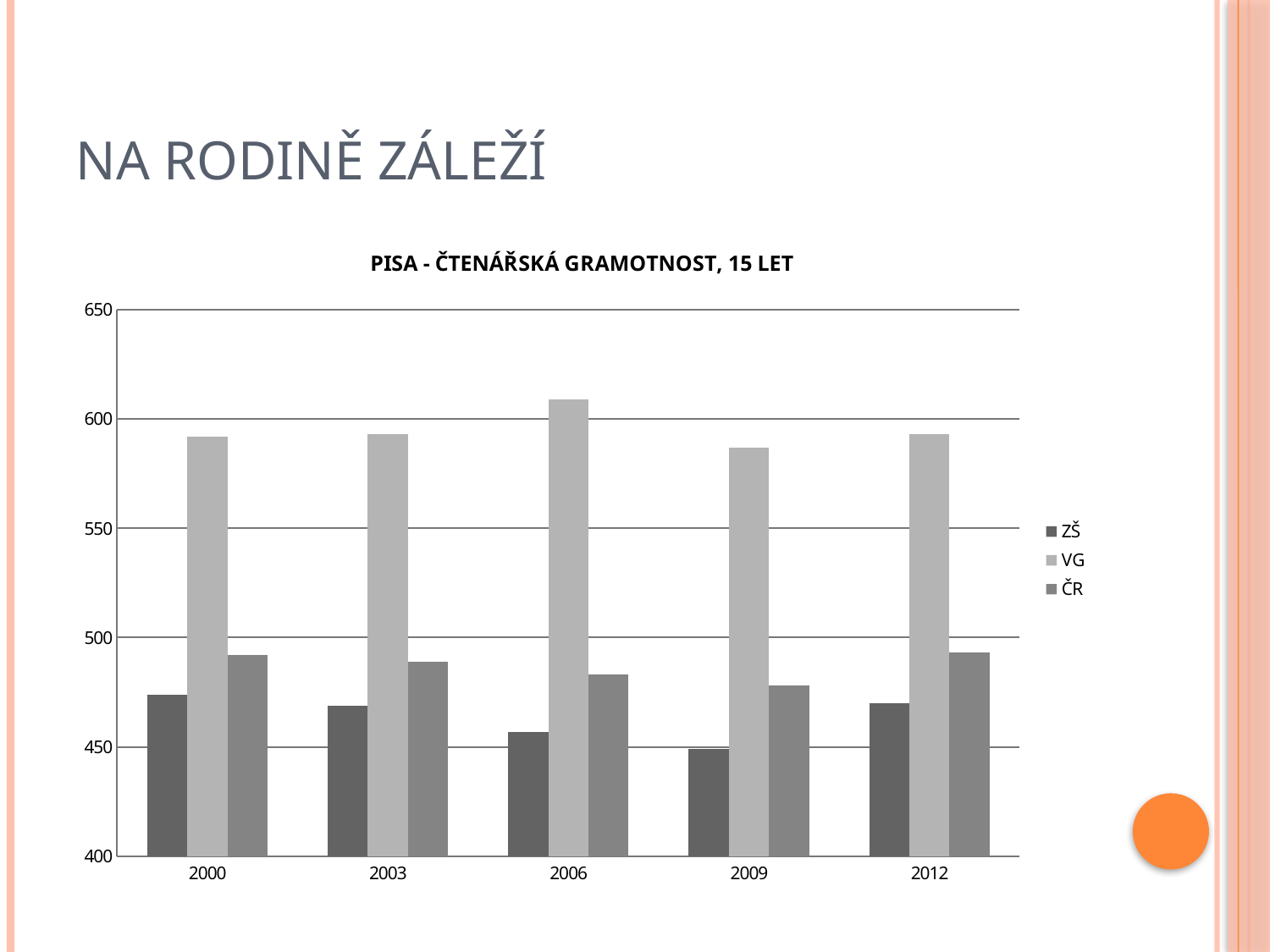
Is the VG value for 2009 greater or less than 600? less Is the VG value for 2006 greater or less than 600? greater In which year is the ZŠ value lowest? 2009 Is the ČR value for 2000 greater or less than 500? less How many years are shown on the x axis? 5 What is the title of the chart? PISA - ČTENÁŘSKÁ GRAMOTNOST, 15 LET In which year is the VG value highest? 2006 Which series are listed in the legend? ZŠ, VG, ČR What kind of chart is shown on the slide? bar chart Which is larger in 2012, the VG value or the ZŠ value? VG Do the ZŠ values rise or fall from 2000 to 2009? fall How many series does the legend list? 3